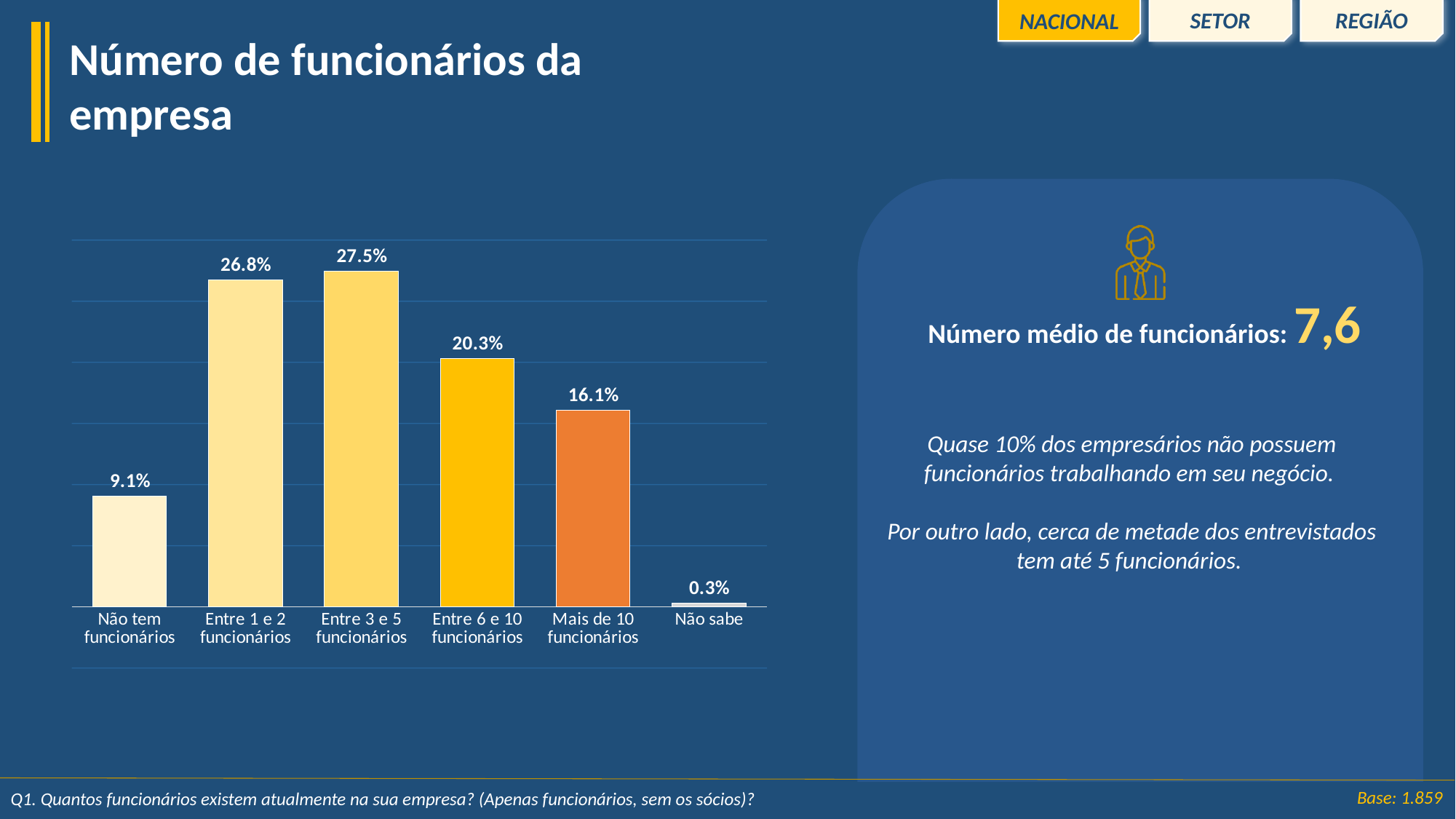
How many categories are shown in the chart? 6 What is the value for 'Não tem funcionários'? 9.1% What is the difference between 'Entre 3 e 5 funcionários' and 'Não tem funcionários'? 18.4% What is the value for 'Entre 3 e 5 funcionários'? 27.5% What is the value for 'Mais de 10 funcionários'? 16.1% What is the title of the slide containing the chart? Número de funcionários da empresa Which category has the lowest value? Não sabe What kind of chart is shown on the slide? Bar chart Which is larger: 'Entre 6 e 10 funcionários' or 'Mais de 10 funcionários'? Entre 6 e 10 funcionários Which category has the highest value? Entre 3 e 5 funcionários What is the difference between 'Entre 1 e 2 funcionários' and 'Entre 6 e 10 funcionários'? 6.5% What is the value for 'Não sabe'? 0.3%